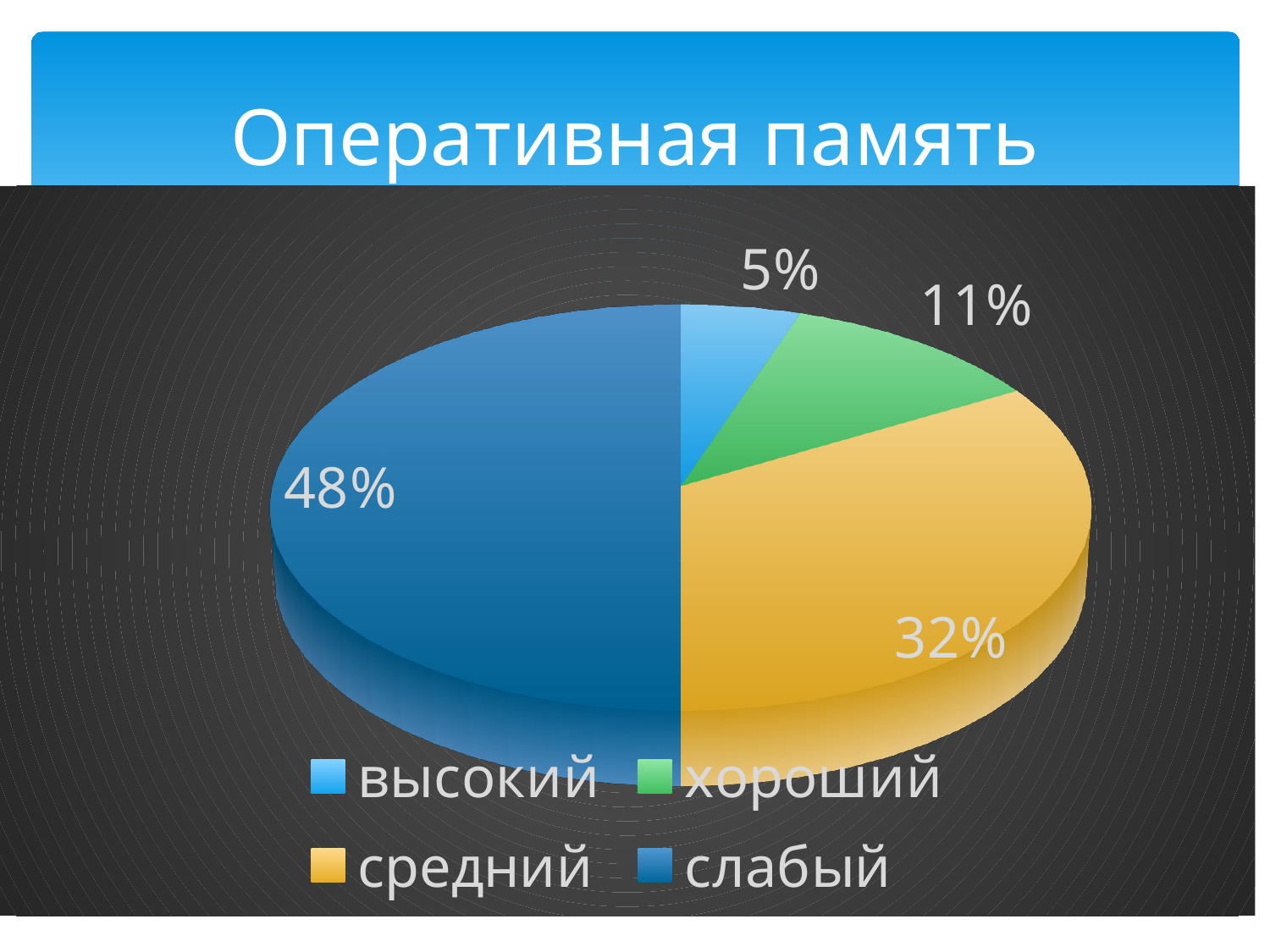
What share of the pie does the 'хороший' slice have? 11% What is the title of the chart? Оперативная память What is the difference between the 'слабый' and 'средний' shares? 16% How many categories does the legend list? 4 What kind of chart is shown on the slide? pie chart Which category has the smallest slice? высокий What share of the pie does the 'средний' slice have? 32% What share of the pie does the 'высокий' slice have? 5% Which is larger, the 'хороший' slice or the 'высокий' slice? хороший Which category has the largest slice? слабый What colour is the 'средний' slice? yellow